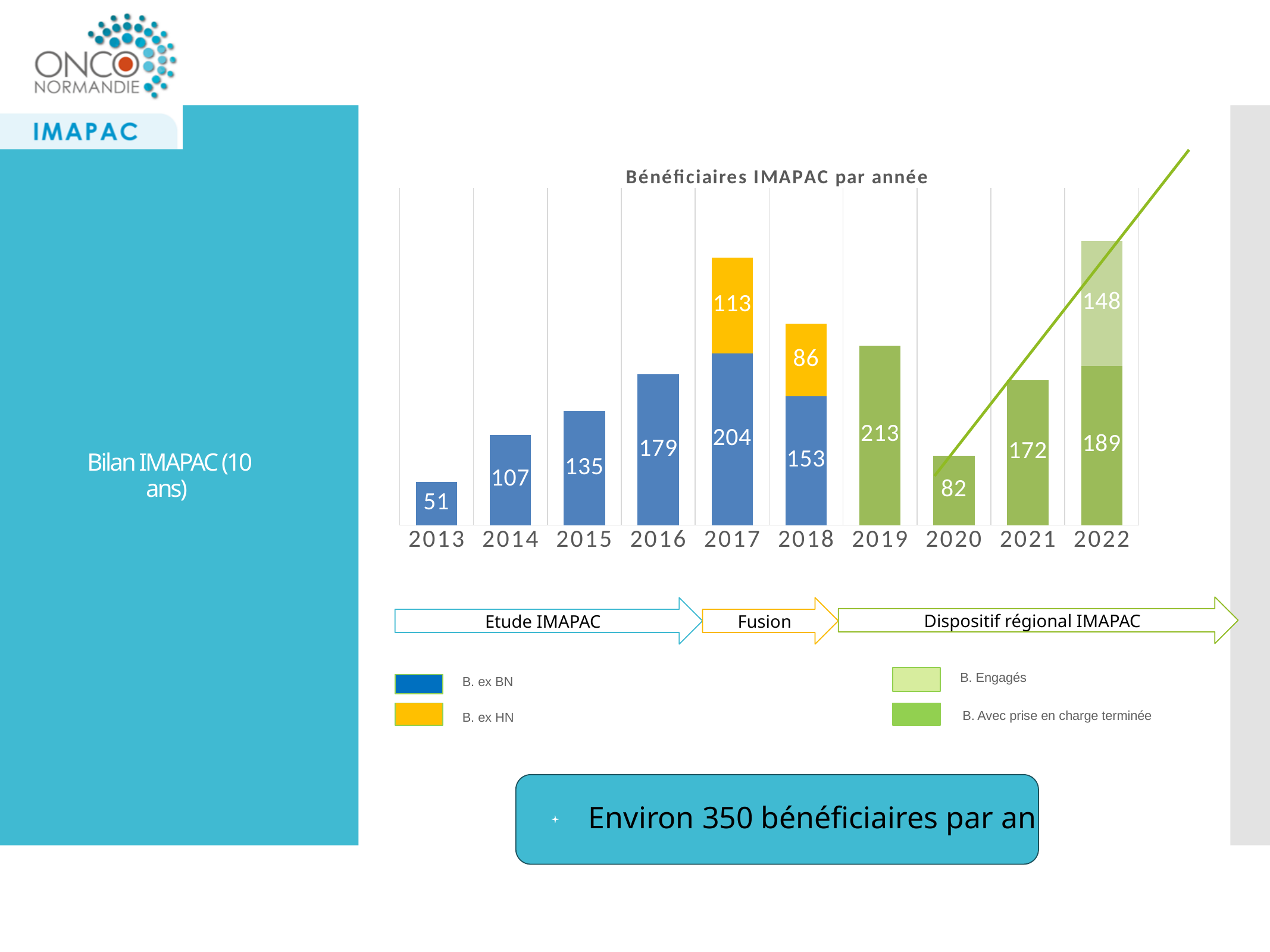
What is the value of the light green (B. Engagés) segment for 2022? 148 What is the total of the stacked bar for 2022? 337 Which year has the lowest value in the chart? 2013 What is the difference between the values for 2016 and 2015? 44 Which year has the largest blue (B. ex BN) segment? 2017 What is the value of the blue (B. ex BN) segment for 2018? 153 What is the total of the stacked bar for 2017? 317 What kind of chart is 'Bénéficiaires IMAPAC par année'? Bar chart Which is larger, the value for 2019 or the value for 2021? 2019 What is the value shown for 2013 in the 'Bénéficiaires IMAPAC par année' chart? 51 How many years are shown on the x axis of the chart? 10 What is the value of the yellow (B. ex HN) segment for 2017? 113